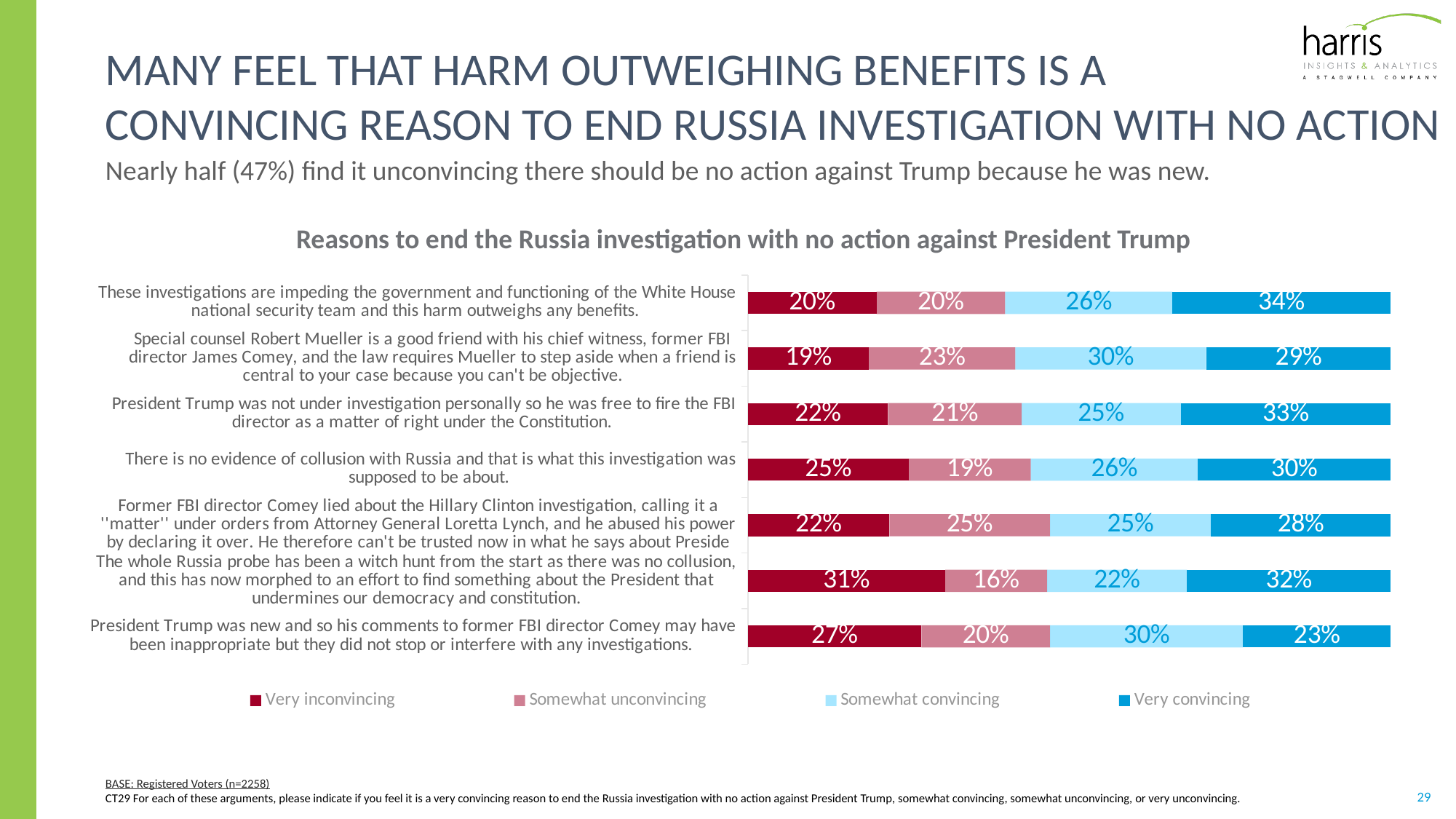
What percentage found the argument that Mueller is a good friend of Comey somewhat convincing? 30% How many reasons (categories) are plotted in the chart? 7 Which reason has the highest 'Very convincing' percentage? These investigations are impeding the government and functioning of the White House national security team and this harm outweighs any benefits. What percentage found the argument that the investigations are impeding the government and the harm outweighs any benefits very convincing? 34% How many series does the legend list? 4 Which is larger: the 'Very convincing' percentage for the 'no evidence of collusion' argument or for the 'Comey lied about the Hillary Clinton investigation' argument? No evidence of collusion (30%) Which reason has the lowest 'Very convincing' percentage? President Trump was new and so his comments to former FBI director Comey may have been inappropriate but they did not stop or interfere with any investigations. What type of chart is shown on the slide? Stacked bar chart For the argument that President Trump was new, what is the combined percentage of 'Very inconvincing' and 'Somewhat unconvincing'? 47% What is the difference between the 'Very inconvincing' percentage for the 'witch hunt' argument and the 'Very inconvincing' percentage for the 'no evidence of collusion' argument? 6% What percentage found the 'witch hunt' argument very inconvincing? 31%